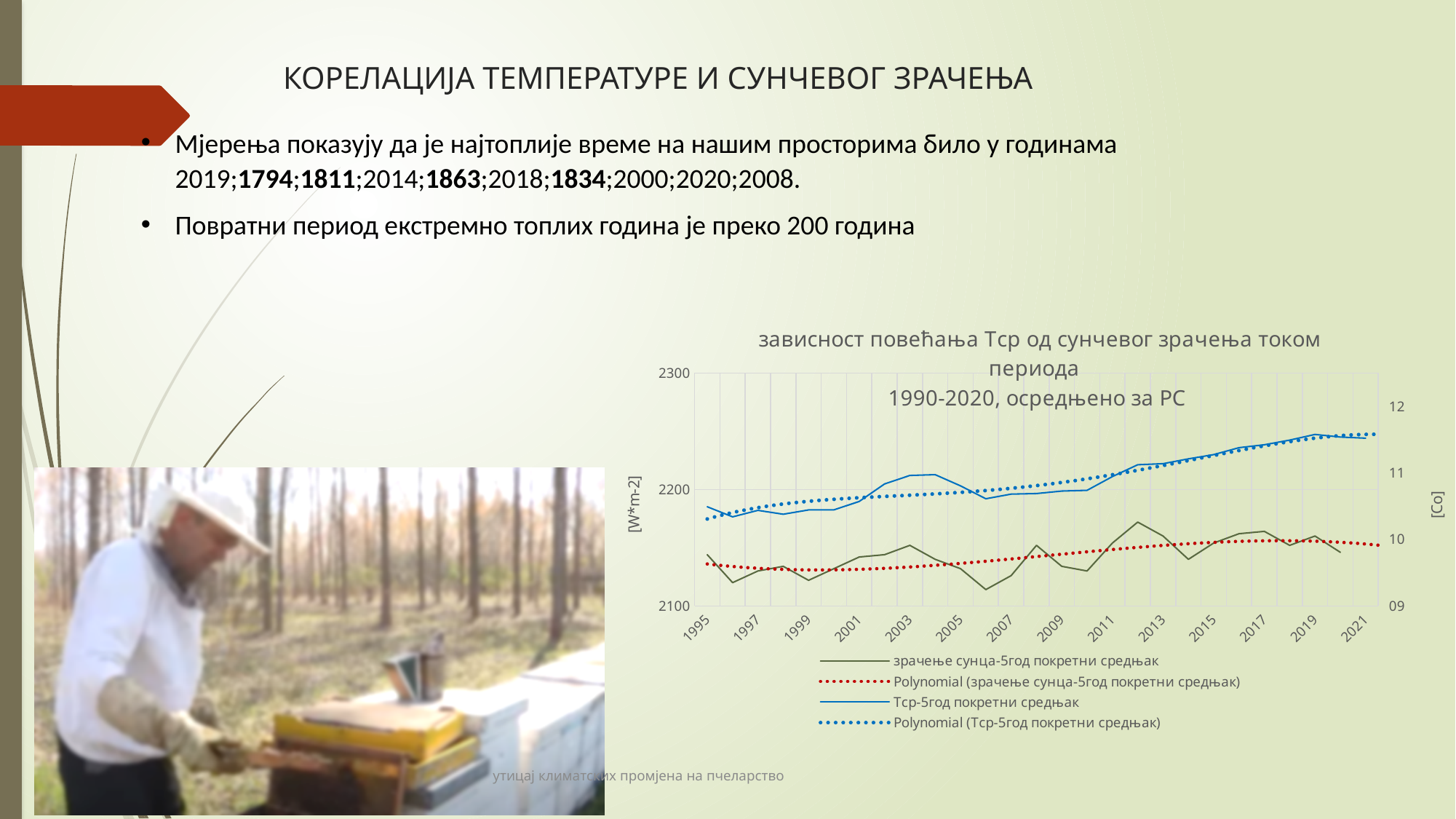
Is the value of the зрачење сунца-5год покретни средњак series in 1995 greater or less than 2200 on the left axis? less Does the Тср-5год покретни средњак series generally rise or fall from 1995 to 2021? rise What kind of chart is shown on the slide? line chart Is the value of the Тср-5год покретни средњак series in 2021 greater or less than 11 on the right axis? greater Which is larger for the Тср-5год покретни средњак series: the value in 1995 or the value in 2021? 2021 Is the value of the зрачење сунца-5год покретни средњак series in 2006 greater or less than 2100 on the left axis? greater How many series does the chart legend list? 4 What is the label of the left vertical axis of the chart? [W*m-2] What is the first year shown on the x axis of the chart? 1995 What is the title of the chart? зависност повећања Тср од сунчевог зрачења током периода 1990-2020, осредњено за РС Which is larger for the зрачење сунца-5год покретни средњак series: the value in 2006 or the value in 2013? 2013